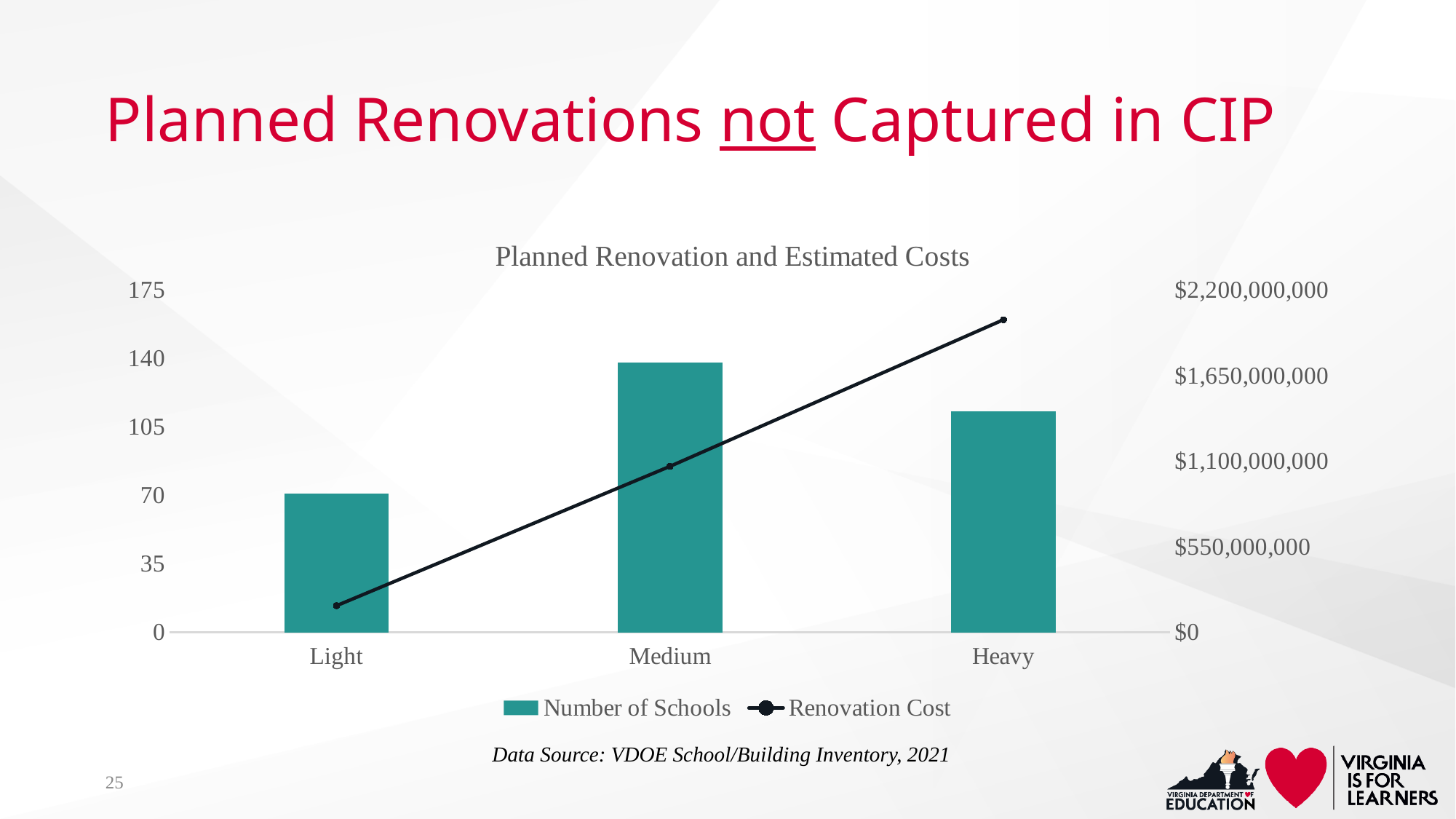
Which category has the highest Number of Schools? Medium Does the Renovation Cost rise or fall from Light to Heavy? Rises Is the Renovation Cost for Light greater or less than $550,000,000? less Which category has the lowest Renovation Cost? Light How many series does the legend list? 2 How many categories are shown on the x axis? 3 Is the Number of Schools for Heavy greater or less than 105? greater Is the Number of Schools for Light greater or less than 105? less Which category has the highest Renovation Cost? Heavy Which category has the lowest Number of Schools? Light What kind of chart is shown on the slide? A combination bar and line chart